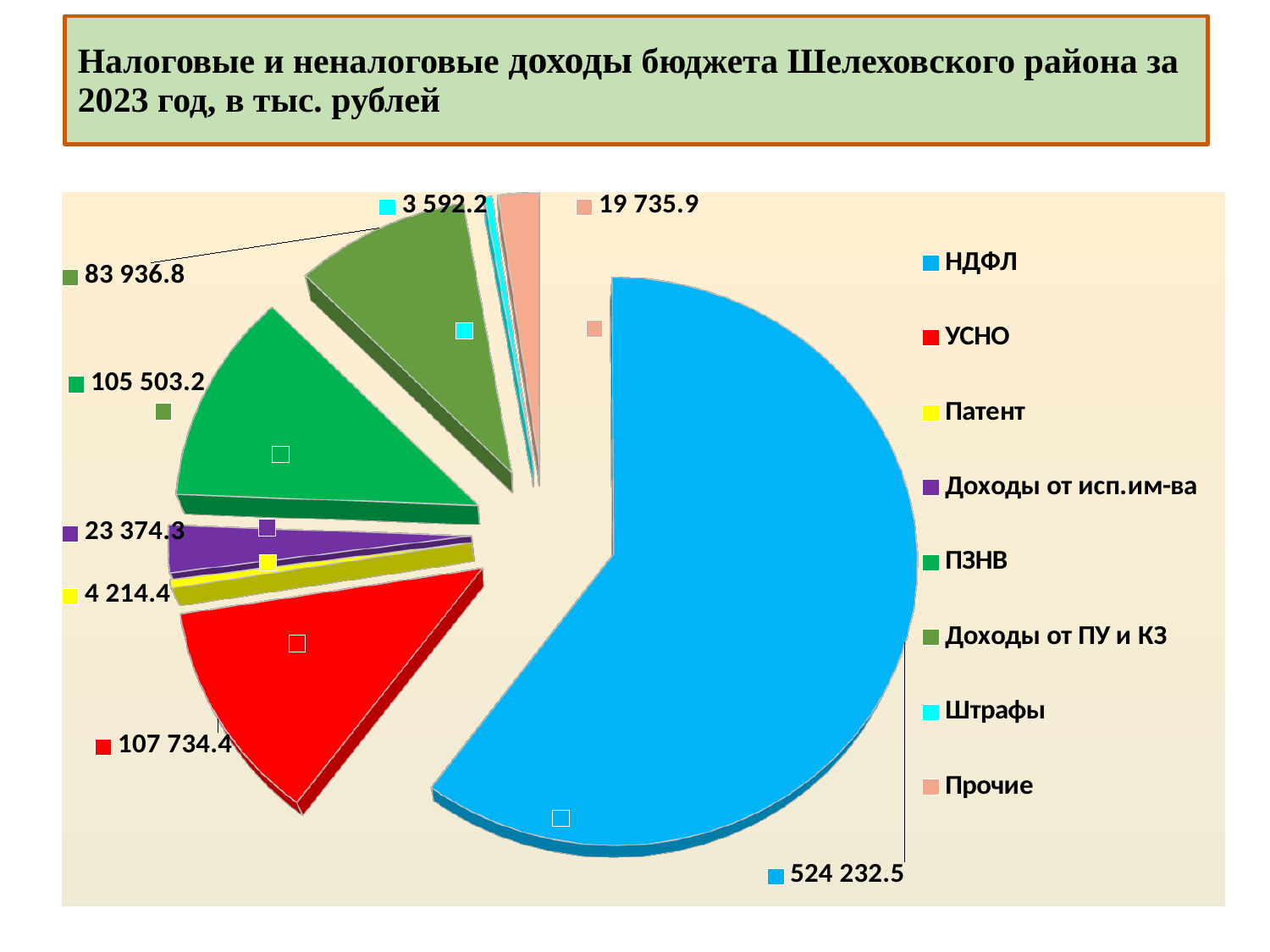
What is the value for УСНО? 107 734.4 What is the value for Прочие? 19 735.9 What is the title of the slide? Налоговые и неналоговые доходы бюджета Шелеховского района за 2023 год, в тыс. рублей Which category has the largest slice? НДФЛ What type of chart is shown on the slide? pie chart What is the value for НДФЛ? 524 232.5 Which is larger, the value for ПЗНВ or the value for Доходы от исп.им-ва? ПЗНВ Which category has the smallest slice? Штрафы What is the difference between the values for НДФЛ and УСНО? 416 498.1 What is the value for Патент? 4 214.4 How many slices does the pie chart have? 8 What is the value for Доходы от ПУ и КЗ? 83 936.8